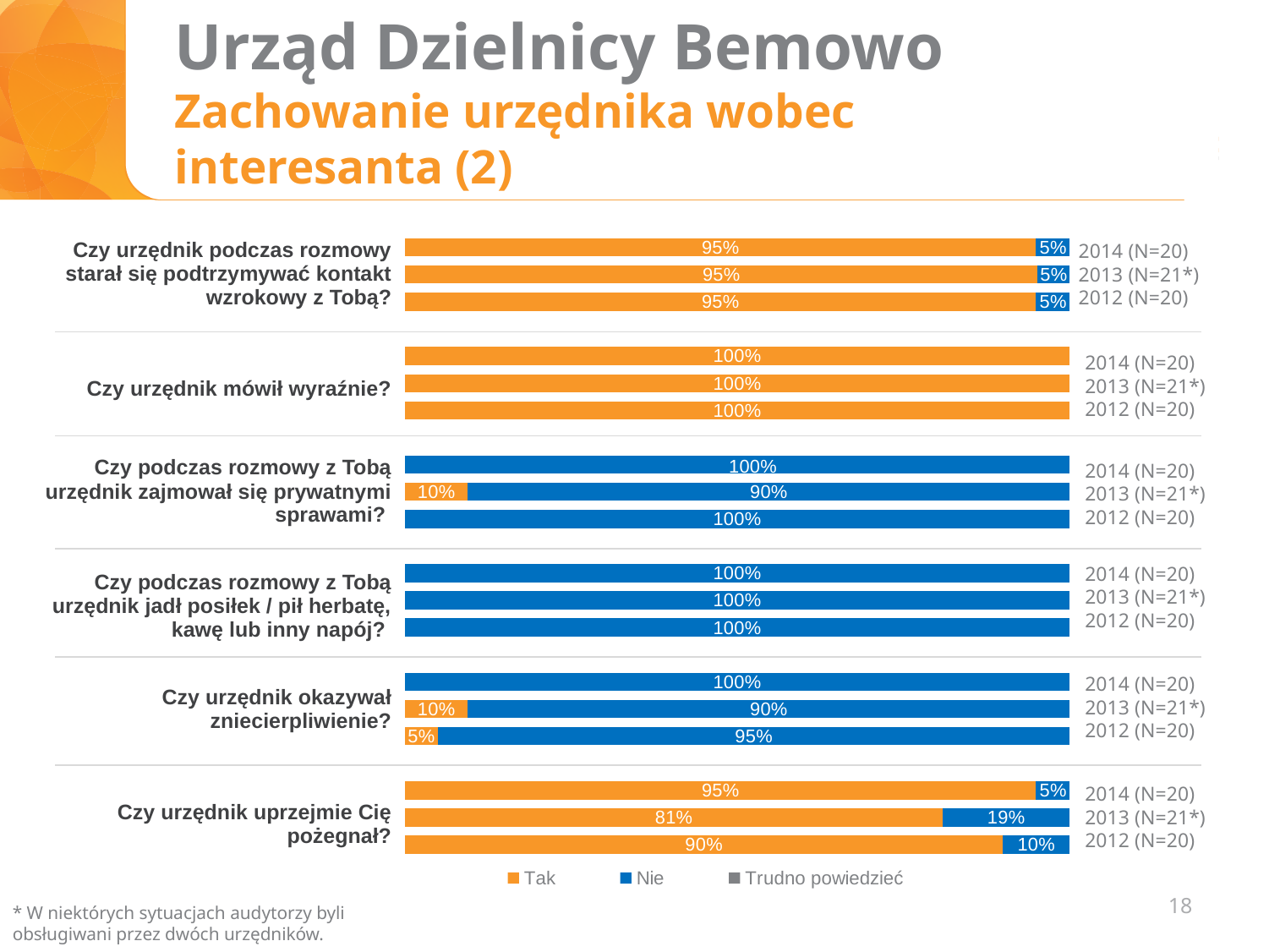
For "Czy urzędnik uprzejmie Cię pożegnał?", which year has the larger "Tak" value, 2012 or 2013? 2012 How many survey questions are shown in the chart? 6 How many series does the legend list? 3 What is the "Tak" value for 2012 for "Czy urzędnik okazywał zniecierpliwienie?"? 5% What percentage answered "Nie" in 2013 for "Czy urzędnik uprzejmie Cię pożegnał?"? 19% What kind of chart is shown on the slide? Stacked bar chart What is the total of the stacked bar for 2013 for "Czy urzędnik uprzejmie Cię pożegnał?"? 100% What are the legend entries of the chart? Tak, Nie, Trudno powiedzieć What is the "Nie" value for 2013 for "Czy podczas rozmowy z Tobą urzędnik zajmował się prywatnymi sprawami?"? 90% What is the "Nie" value for 2014 for "Czy urzędnik podczas rozmowy starał się podtrzymywać kontakt wzrokowy z Tobą?"? 5% What percentage answered "Tak" in 2013 for "Czy urzędnik uprzejmie Cię pożegnał?"? 81% For "Czy urzędnik uprzejmie Cię pożegnał?" in 2013, what is the difference between the "Tak" and "Nie" values? 62 percentage points